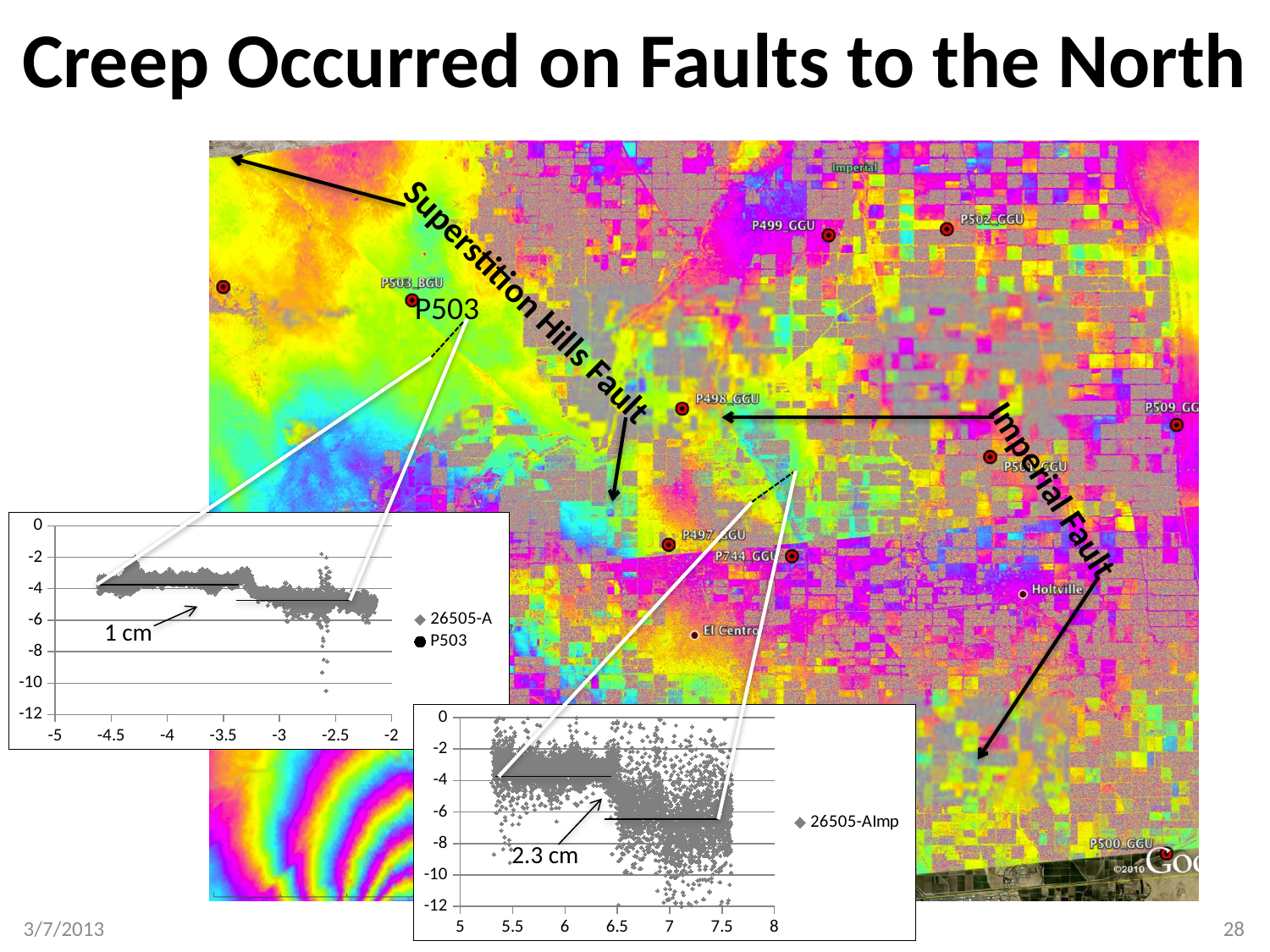
What is the legend entry of the lower-right chart? 26505-AImp What kind of chart is the lower-right chart (the one with legend entry 26505-AImp)? scatter chart In the left chart, do the plotted values rise or fall as the x axis increases past -3.5? fall What offset is annotated on the lower-right chart? 2.3 cm What kind of chart is the left chart (the one with legend entries 26505-A and P503)? scatter chart What is the difference between the annotated offsets of the lower-right chart (2.3 cm) and the left chart (1 cm)? 1.3 cm Which chart shows the larger annotated offset, the left chart (1 cm) or the lower-right chart (2.3 cm)? the lower-right chart What offset is annotated on the left chart? 1 cm What are the legend entries of the left chart? 26505-A and P503 How many series does the legend of the lower-right chart list? 1 How many series does the legend of the left chart list? 2 In the lower-right chart, do the plotted values rise or fall as the x axis increases past 6.5? fall